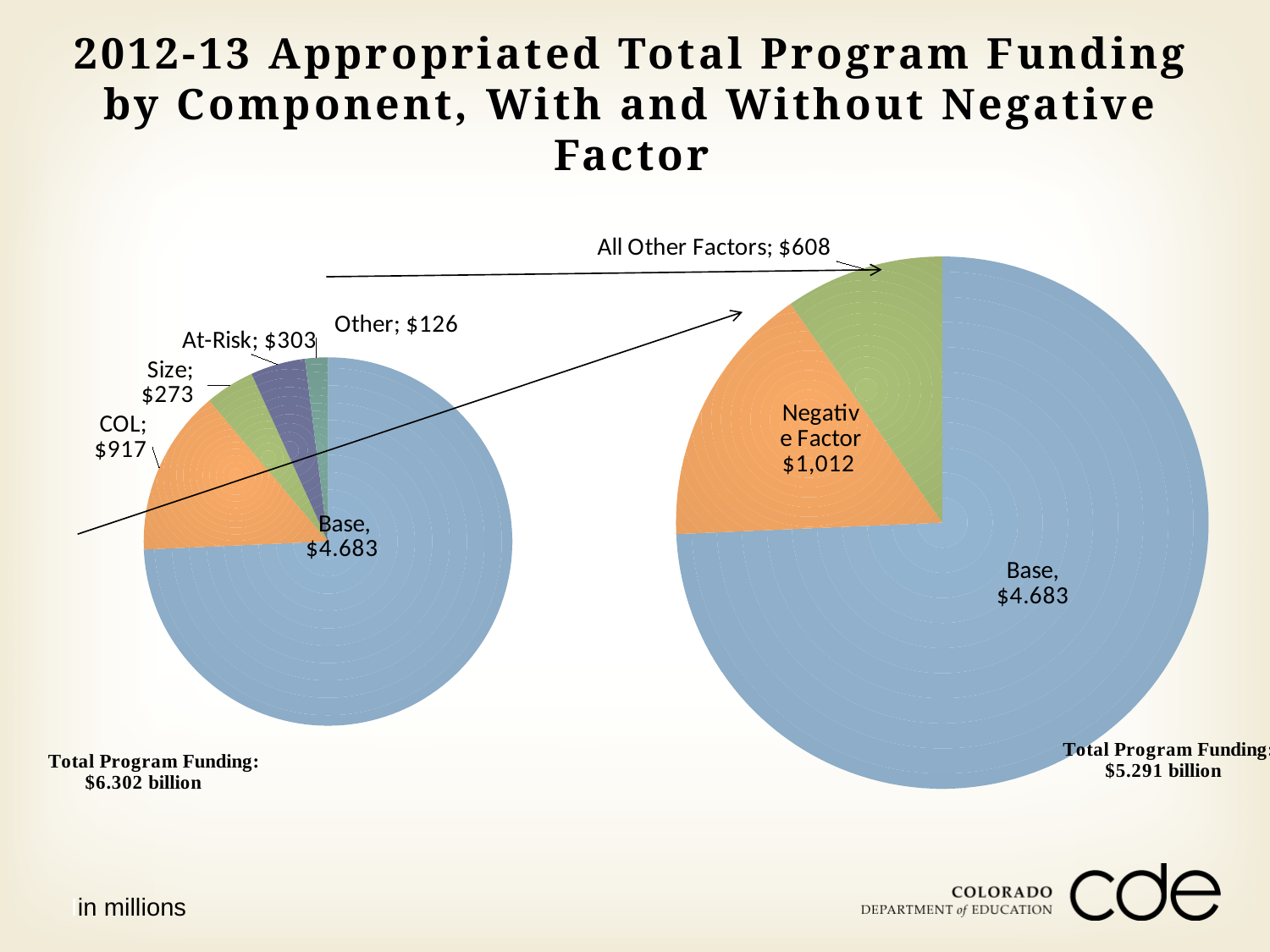
In the left pie chart, what is the value shown for At-Risk? $303 How many slices does the right pie chart have? 3 How many slices does the left pie chart have? 5 In the right pie chart, which is larger, Negative Factor or All Other Factors? Negative Factor In the right pie chart, which slice is the smallest? All Other Factors In the left pie chart, what is the difference between the COL value and the Size value? $644 In the right pie chart, what is the value shown for All Other Factors? $608 In the right pie chart, what is the value shown for Negative Factor? $1,012 In the left pie chart, which slice is the smallest? Other What type of chart is used on this slide? Pie chart In the left pie chart, which slice is the largest? Base In the left pie chart, what is the value shown for COL? $917